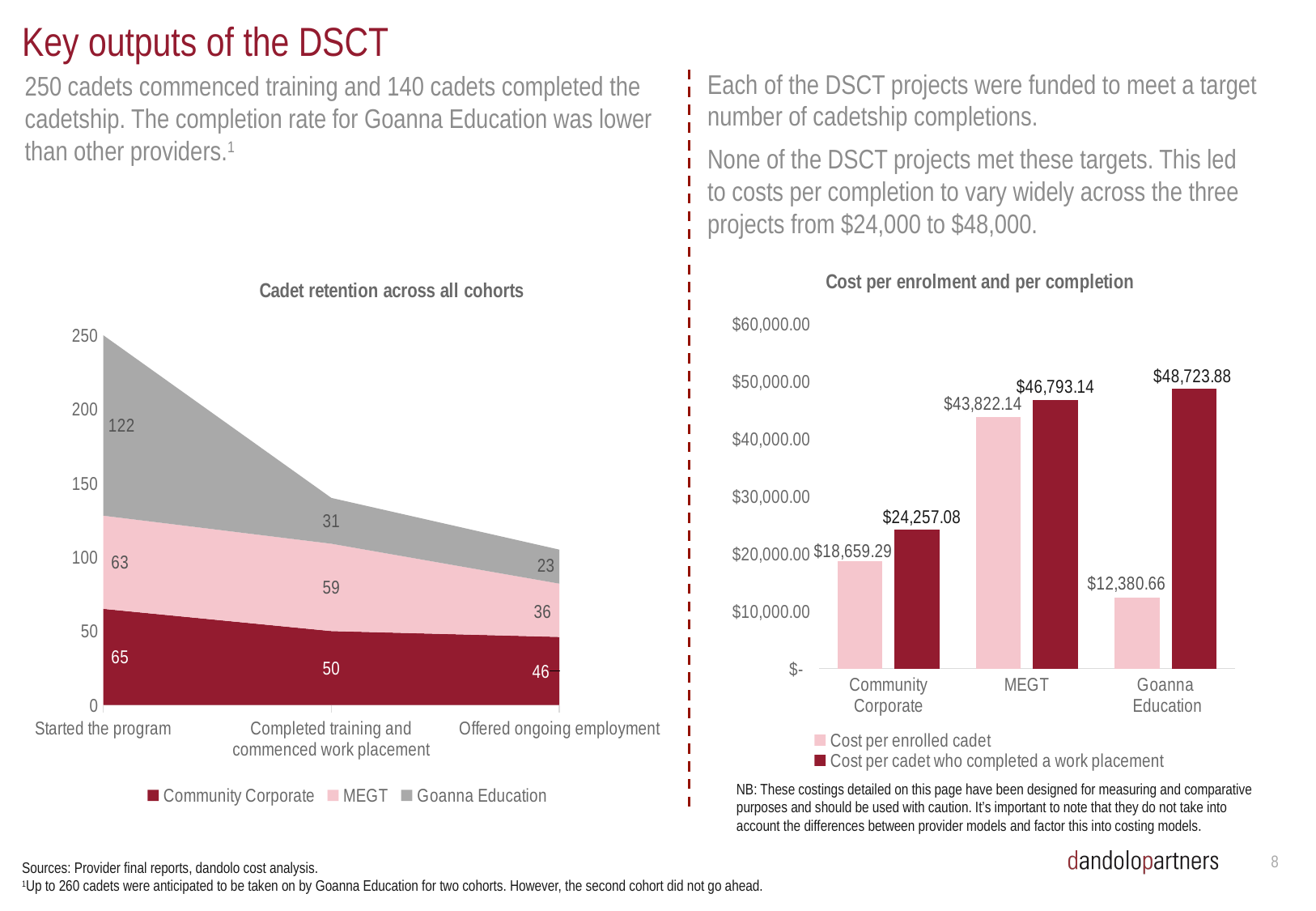
In the 'Cost per enrolment and per completion' chart, what is the cost per enrolled cadet for Community Corporate? $18,659.29 In the 'Cadet retention across all cohorts' chart, what is the total across all three providers at 'Completed training and commenced work placement'? 140 In the 'Cost per enrolment and per completion' chart, which provider has the lowest cost per enrolled cadet? Goanna Education In the 'Cost per enrolment and per completion' chart, what is the cost per cadet who completed a work placement for Goanna Education? $48,723.88 In the 'Cadet retention across all cohorts' chart, what is the difference between Goanna Education's value at 'Started the program' and at 'Completed training and commenced work placement'? 91 In the 'Cost per enrolment and per completion' chart, which is larger: the cost per enrolled cadet for MEGT or for Community Corporate? MEGT In the 'Cadet retention across all cohorts' chart, what is the value for Community Corporate at 'Offered ongoing employment'? 46 In the 'Cost per enrolment and per completion' chart, what is the difference between MEGT's cost per cadet who completed a work placement and its cost per enrolled cadet? $2,971.00 In the 'Cadet retention across all cohorts' chart, what is the value for Goanna Education at 'Started the program'? 122 How many series does the legend of the 'Cadet retention across all cohorts' chart list? 3 What kind of chart is 'Cadet retention across all cohorts'? stacked area chart In the 'Cadet retention across all cohorts' chart, does the total number of cadets rise or fall from left to right along the x axis? fall